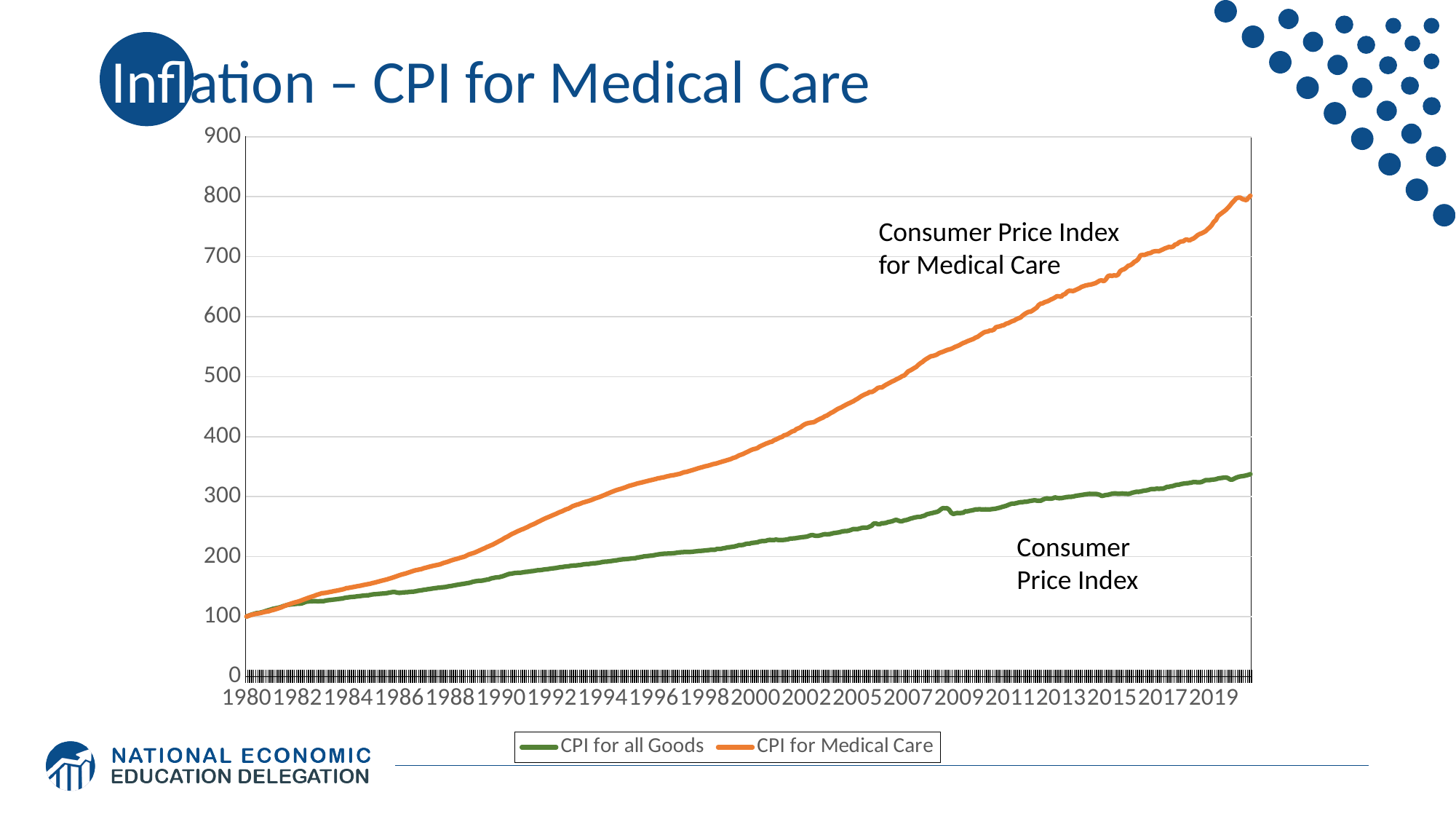
What kind of chart is shown on the slide? line chart Is the value for CPI for all Goods in 2019 greater or less than 300? greater How many series does the legend list? 2 Is the value for CPI for Medical Care in 2005 greater or less than 400? greater Is the value for CPI for all Goods in 1990 greater or less than 200? less At what value do both series start in 1980? 100 Does the CPI for Medical Care line rise or fall from 1980 to 2019? rise What is the title of the slide? Inflation – CPI for Medical Care What are the two series named in the legend? CPI for all Goods and CPI for Medical Care Which series is higher in 2019, CPI for all Goods or CPI for Medical Care? CPI for Medical Care Does the CPI for all Goods line rise or fall over the period shown? rise Which series is higher in 2005, CPI for all Goods or CPI for Medical Care? CPI for Medical Care